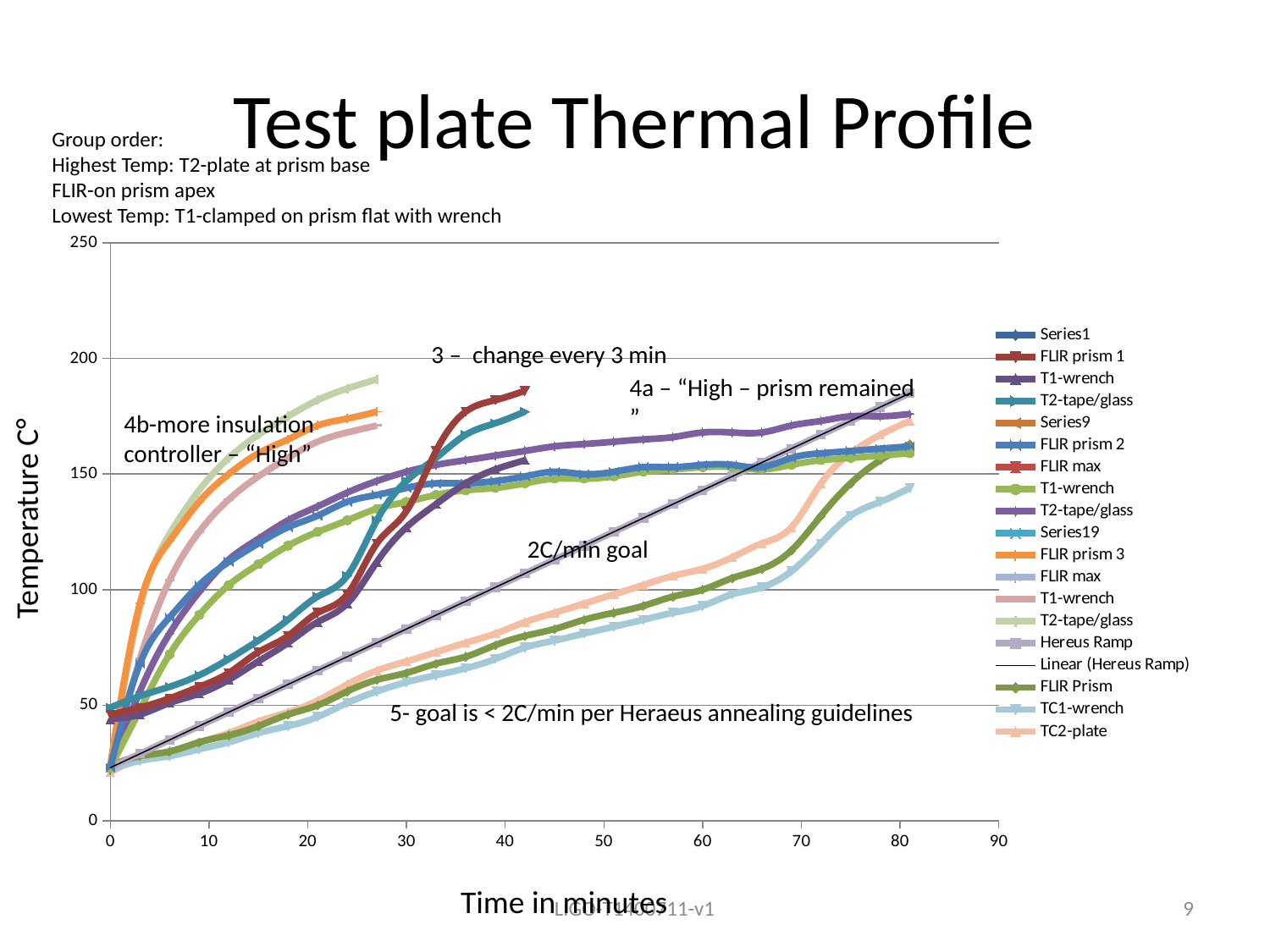
At 80 minutes, which series is lower: TC1-wrench or TC2-plate? TC1-wrench What is the highest value shown on the horizontal axis? 90 What is the highest value shown on the vertical axis? 250 What is the label on the vertical axis? Temperature C° How many series does the legend list? 19 What is the title of the chart? Test plate Thermal Profile Does the Hereus Ramp series rise or fall as time increases? rise Is the value for Hereus Ramp at 20 minutes greater or less than 50? greater What kind of chart is shown on the slide? line chart Is the value for Hereus Ramp at 80 minutes greater or less than 150? greater Is the value for TC1-wrench at 60 minutes greater or less than 100? less